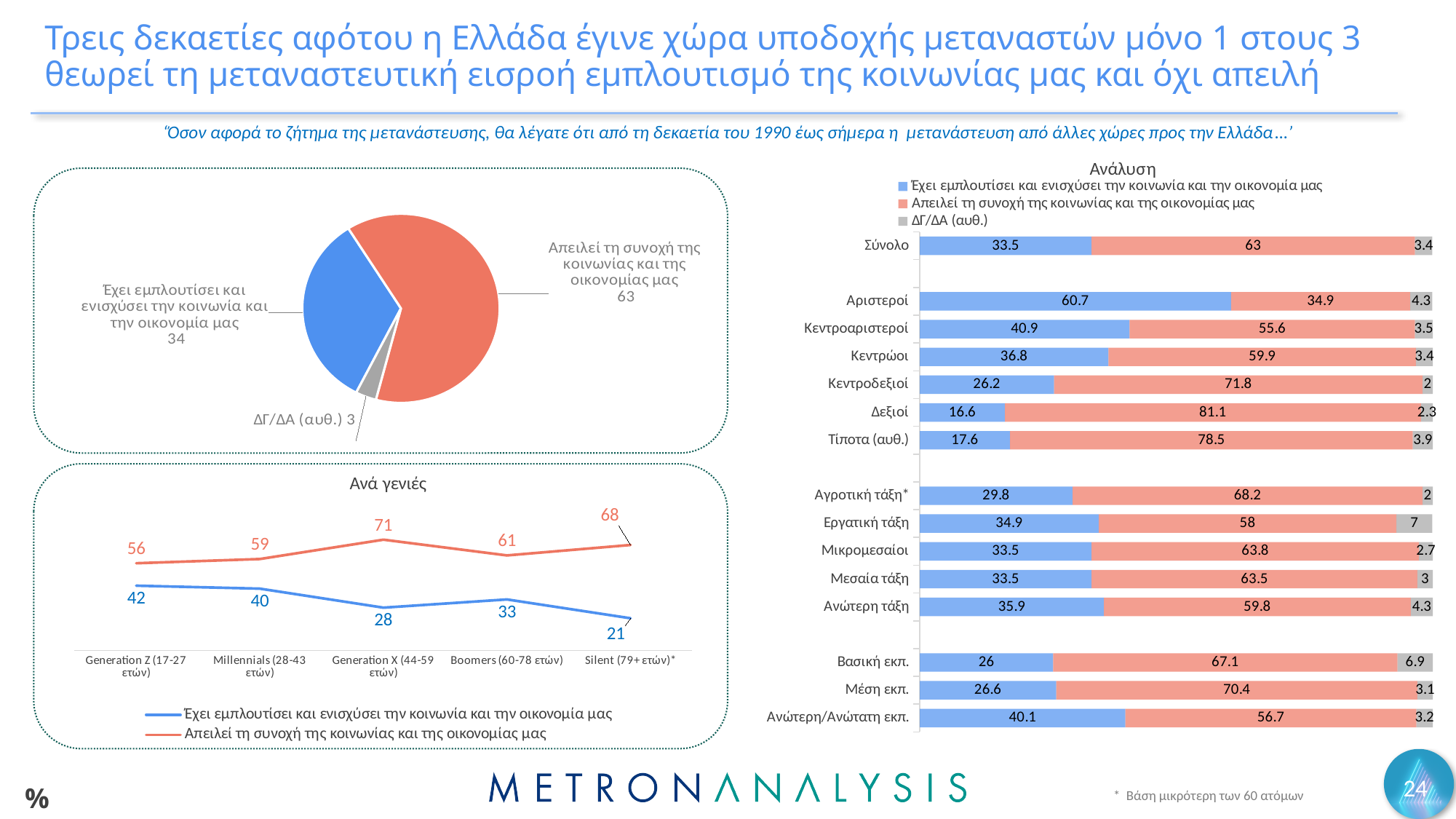
In the 'Ανάλυση' chart on the right, which category has the highest value for 'Απειλεί τη συνοχή της κοινωνίας και της οικονομίας μας'? Δεξιοί In the 'Ανάλυση' chart on the right, what is the value of 'Έχει εμπλουτίσει και ενισχύσει την κοινωνία και την οικονομία μας' for Αριστεροί? 60.7 What kind of chart is the 'Ανάλυση' chart on the right? Stacked bar chart In the 'Ανάλυση' chart on the right, what is the total of the three segments for Δεξιοί? 100 How many generation categories are shown on the x axis of the 'Ανά γενιές' line chart? 5 In the pie chart on the left, what value is shown for 'ΔΓ/ΔΑ (αυθ.)'? 3 In the 'Ανά γενιές' line chart, what is the difference between the red and blue values for Generation X (44-59 ετών)? 43 In the 'Ανά γενιές' line chart, what is the value of the red series ('Απειλεί τη συνοχή...') for Generation X (44-59 ετών)? 71 In the pie chart on the left, what value is shown for the slice 'Απειλεί τη συνοχή της κοινωνίας και της οικονομίας μας'? 63 In the 'Ανάλυση' chart on the right, is the 'Έχει εμπλουτίσει...' value larger for Κεντροαριστεροί or for Κεντρώοι? Κεντροαριστεροί How many series does the legend of the 'Ανάλυση' chart on the right list? 3 In the 'Ανά γενιές' line chart, which generation has the lowest value for the blue series ('Έχει εμπλουτίσει...')? Silent (79+ ετών)*